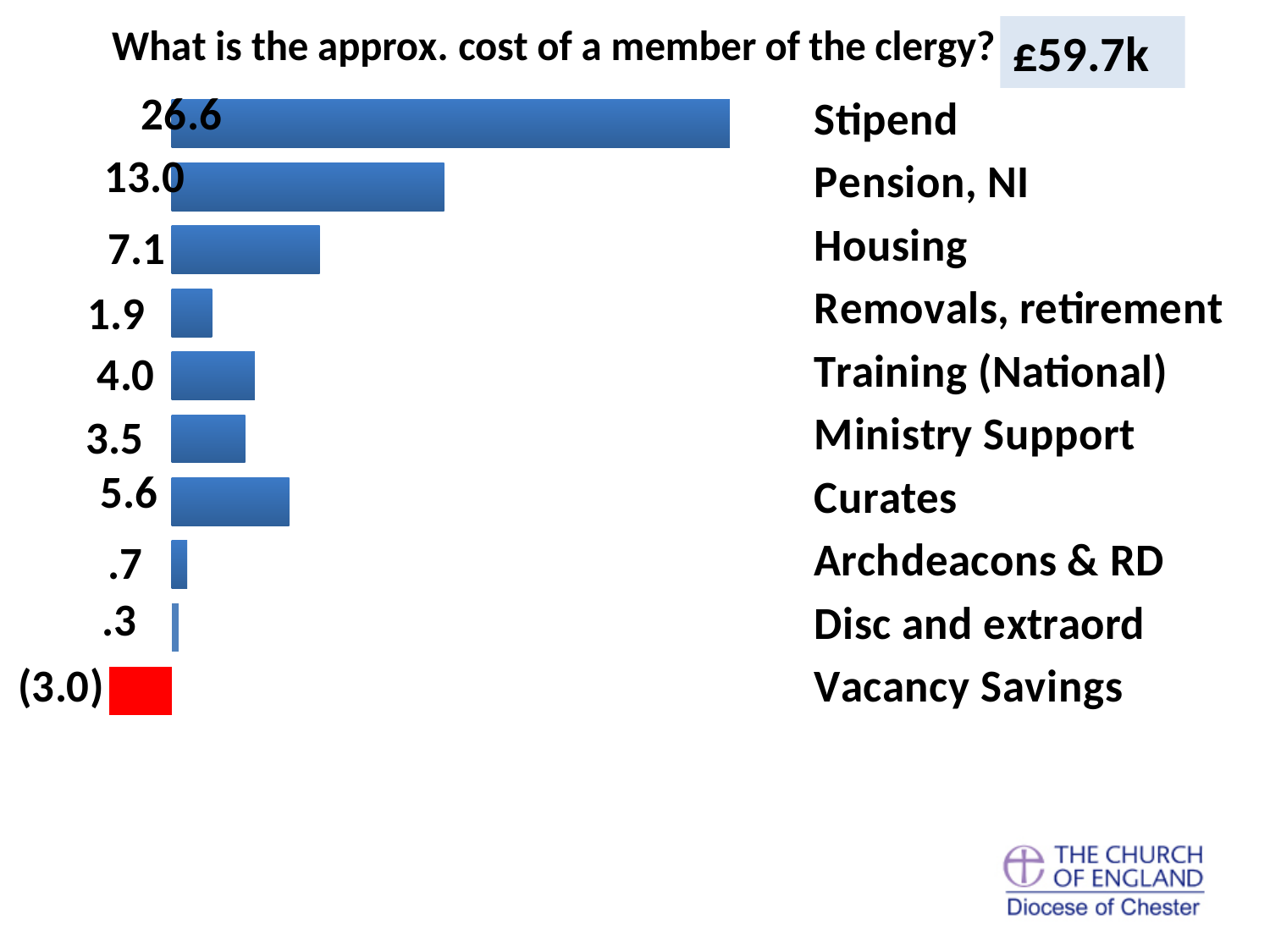
What is the value shown for Curates? 5.6 How many categories are shown in the chart? 10 What is the value shown for Pension, NI? 13.0 What is the difference between the values for Housing and Curates? 1.5 What is the value shown for Stipend? 26.6 What is the value shown for Vacancy Savings? (3.0) What is the difference between the values for Stipend and Pension, NI? 13.6 Which category has the largest bar? Stipend What kind of chart is shown on the slide? Bar chart Which category has the smallest positive value? Disc and extraord Which is larger, the value for Training (National) or the value for Ministry Support? Training (National) Which category's bar is coloured red? Vacancy Savings